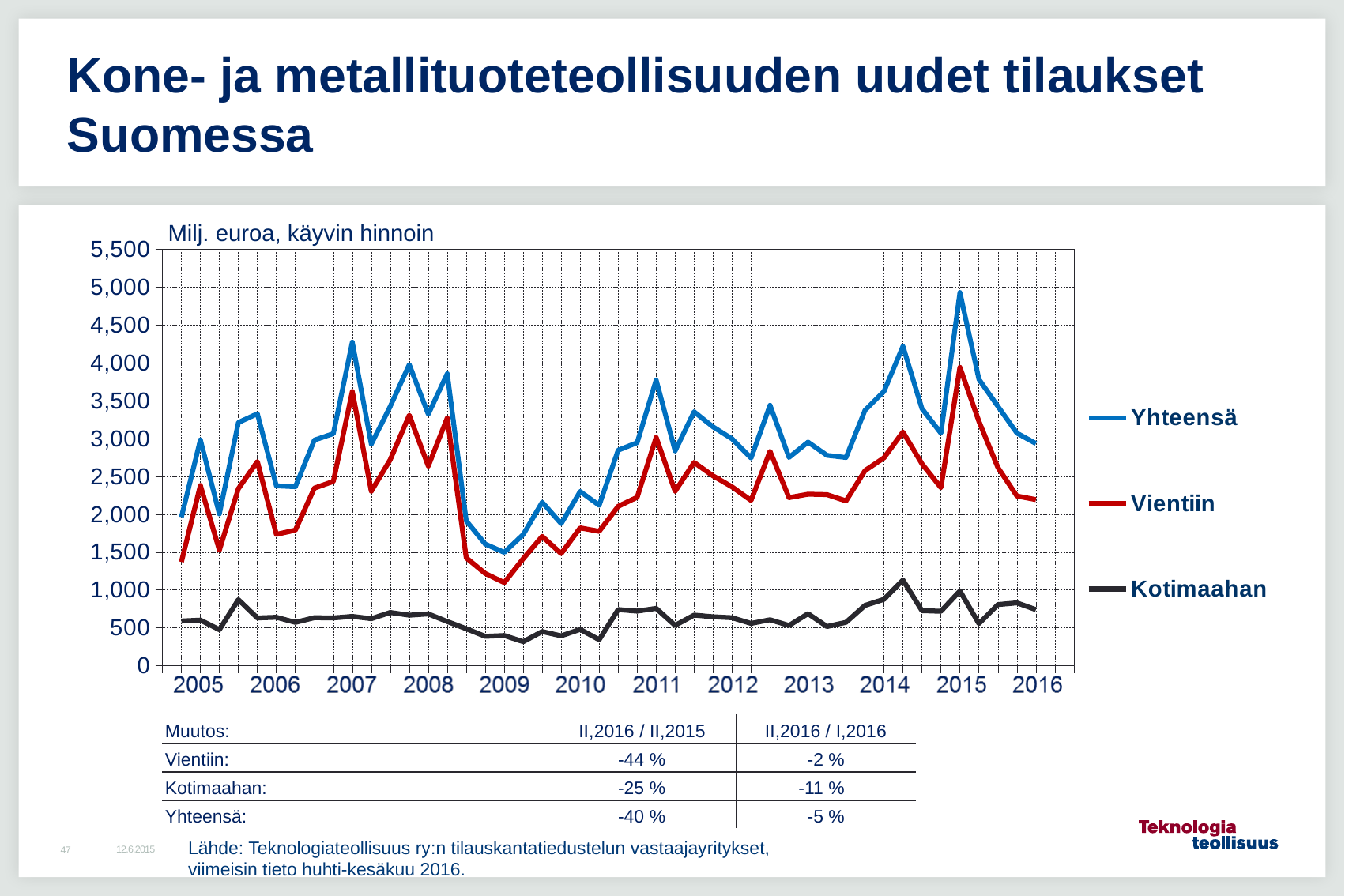
Which series has the highest values throughout the chart? Yhteensä How many series does the chart legend list? 3 What unit label is shown above the chart's y axis? Milj. euroa, käyvin hinnoin Which series is larger in 2012, Vientiin or Kotimaahan? Vientiin What kind of chart is shown on the slide? line chart Which series has the lowest values throughout the chart? Kotimaahan Is the peak value of Yhteensä in 2015 greater or less than 4,500? greater Is the lowest value of Vientiin in 2009 greater or less than 1,500? less Does the Yhteensä series rise or fall from its 2015 peak to 2016? fall What are the three series named in the chart legend? Yhteensä, Vientiin, Kotimaahan How many year labels are shown on the x axis of the chart? 12 Is the highest value of Kotimaahan in 2014 greater or less than 1,500? less